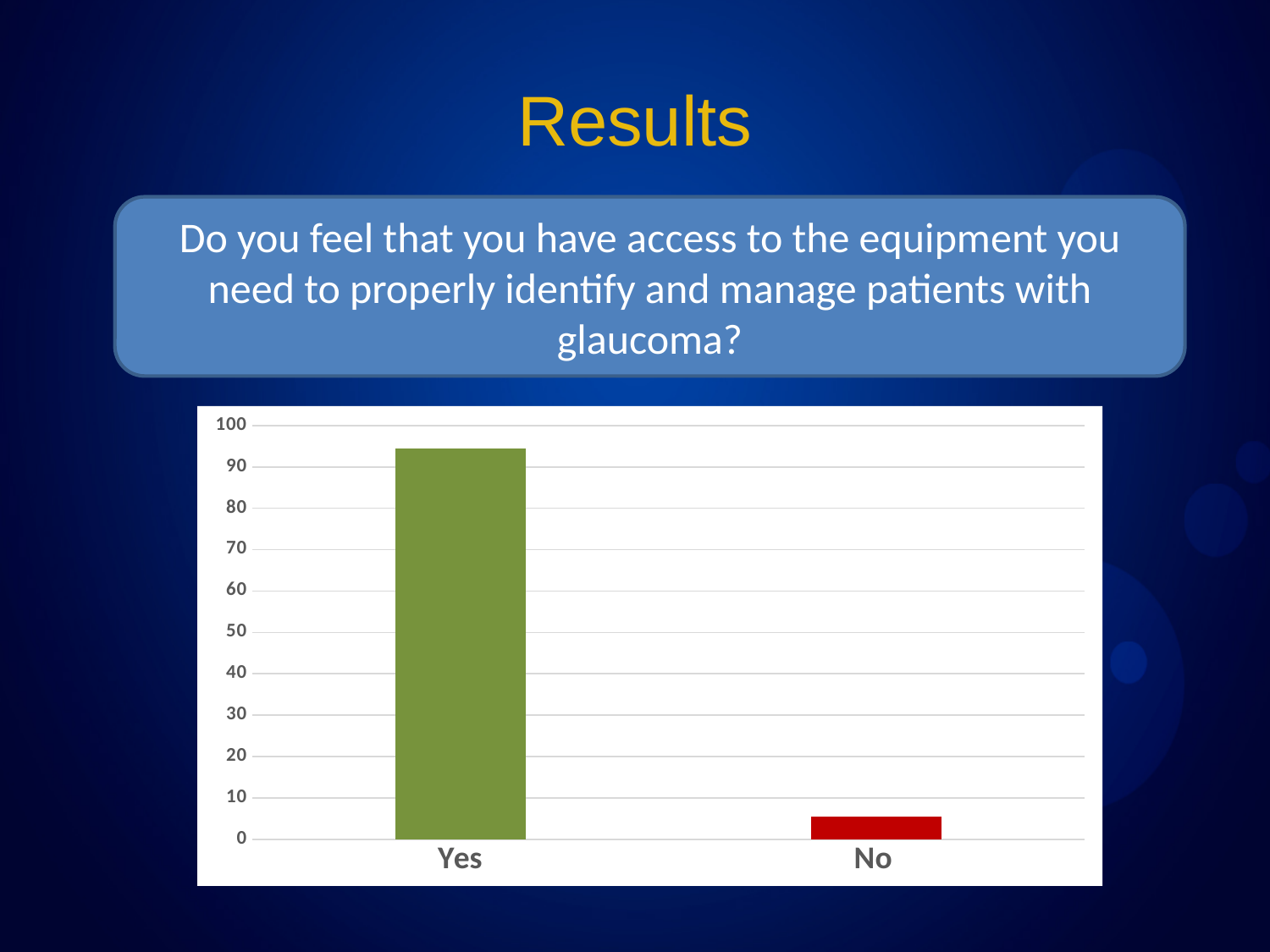
How many categories are shown on the x axis of the chart? 2 What kind of chart is shown on the slide? bar chart What is the highest tick value shown on the y axis of the chart? 100 Is the value for Yes greater or less than 90? greater Which category has the lowest value in the chart? No Is the value for Yes greater or less than 100? less Which category has the highest value in the chart? Yes What colour is the bar for the No category? red Which is larger, the value for Yes or the value for No? Yes Is the value for No greater or less than 10? less